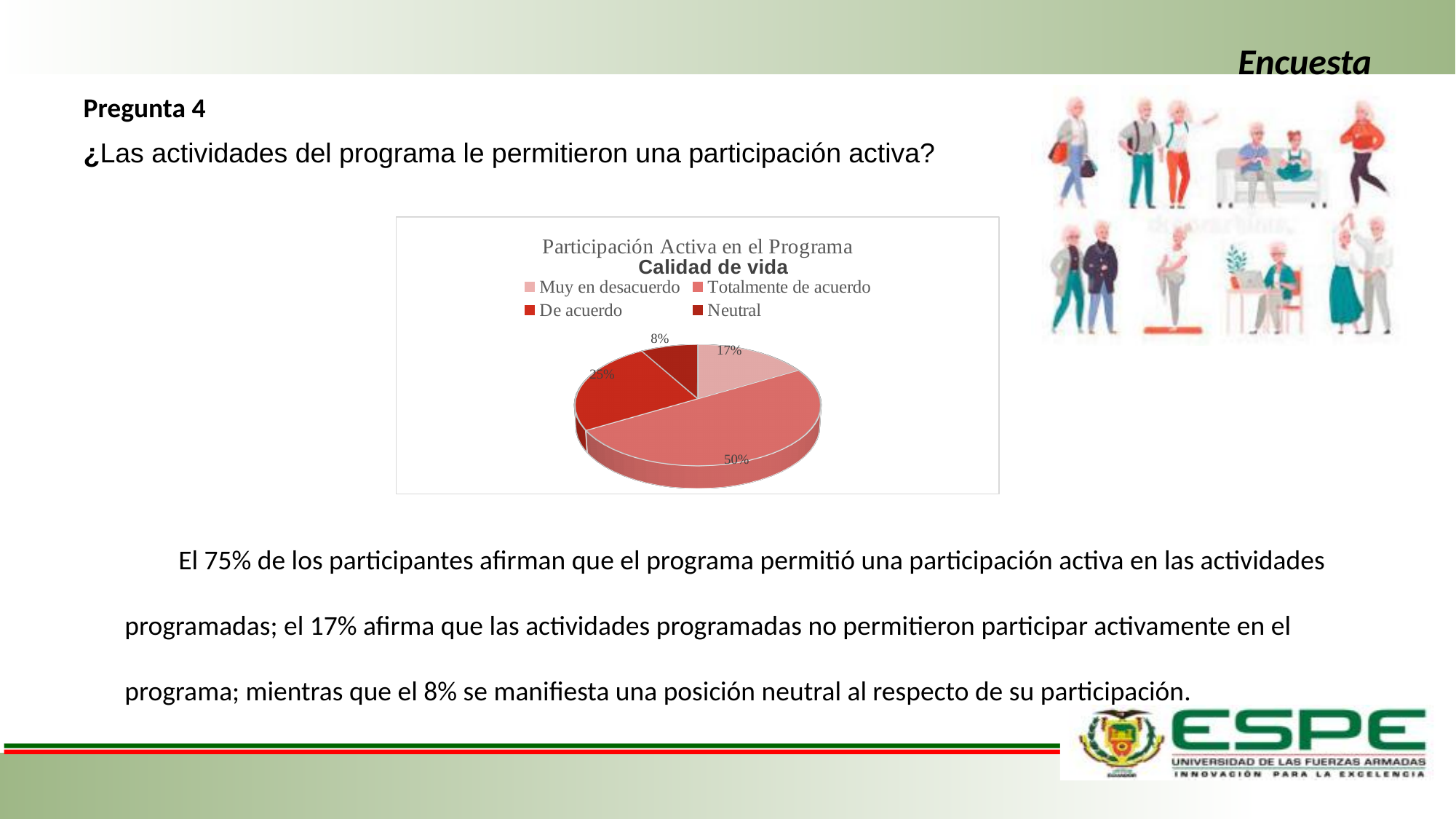
Which is larger, the share for 'Muy en desacuerdo' or the share for 'Neutral'? Muy en desacuerdo Which category has the largest share of the pie? Totalmente de acuerdo What percentage of the pie corresponds to 'Totalmente de acuerdo'? 50% How many categories does the legend of the pie chart list? 4 What percentage of the pie corresponds to 'Muy en desacuerdo'? 17% What is the difference in percentage points between 'Totalmente de acuerdo' and 'De acuerdo'? 25 Which category has the smallest share of the pie? Neutral What percentage of the pie corresponds to 'Neutral'? 8% What kind of chart is shown on the slide? Pie chart What is the combined share of 'Totalmente de acuerdo' and 'De acuerdo'? 75% What percentage of the pie corresponds to 'De acuerdo'? 25% What is the title of the chart? Participación Activa en el Programa